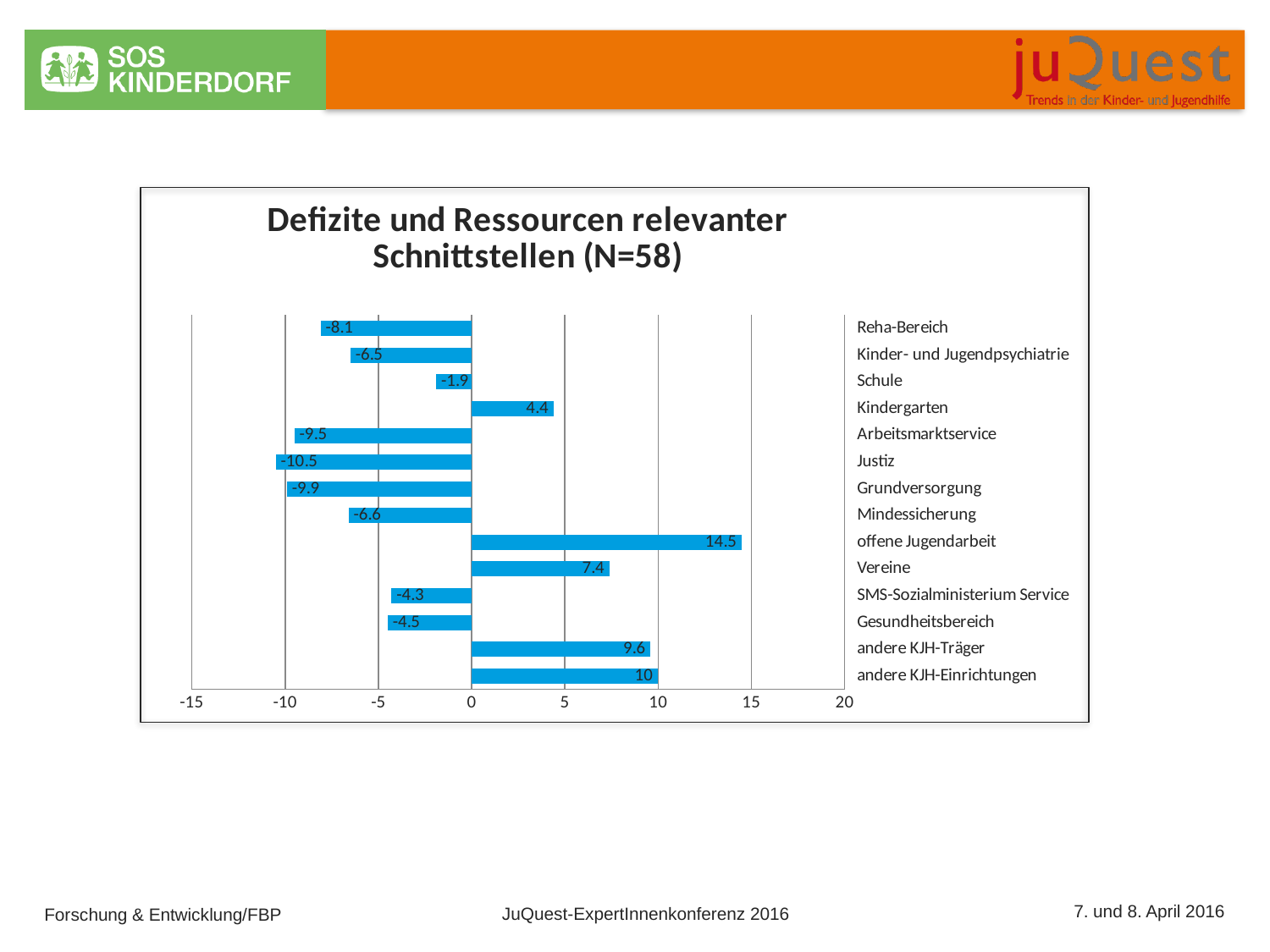
Which category has the highest value? offene Jugendarbeit What is the value for Schule? -1.9 Which is larger, the value for Kindergarten or the value for Vereine? Vereine What is the value for andere KJH-Einrichtungen? 10 What kind of chart is shown on the slide? bar chart Which category has the lowest value? Justiz What is the value for Justiz? -10.5 What is the value for offene Jugendarbeit? 14.5 How many categories are shown in the chart? 14 What is the difference between the values for offene Jugendarbeit and andere KJH-Einrichtungen? 4.5 What is the title of the chart? Defizite und Ressourcen relevanter Schnittstellen (N=58) Is the value for offene Jugendarbeit greater or less than 10? greater